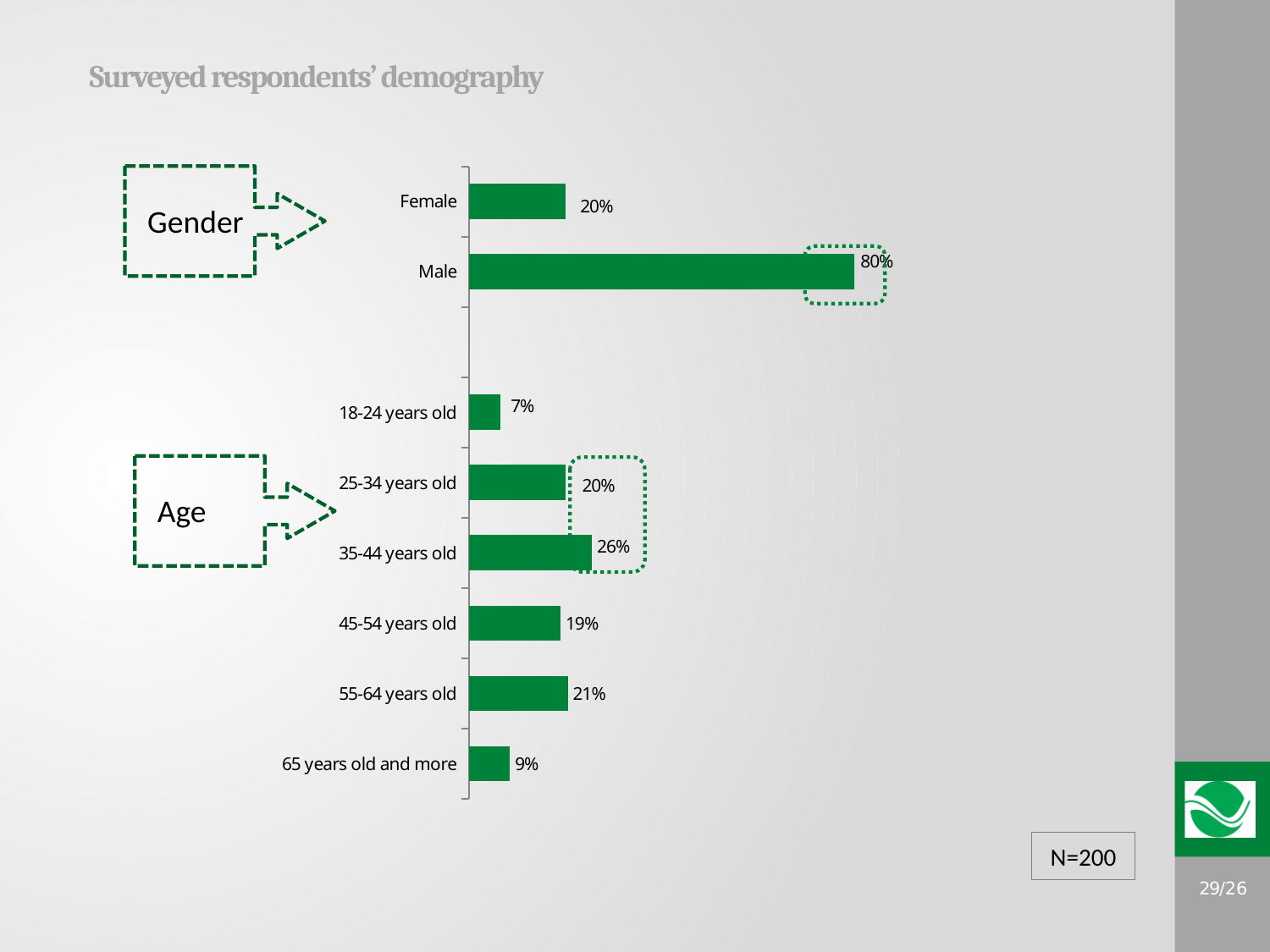
Which is larger, the share of respondents aged 55-64 years old or 45-54 years old? 55-64 years old What percentage of surveyed respondents are female? 20% What is the difference between the 35-44 years old and 45-54 years old shares? 7% Which age group has the highest share of respondents? 35-44 years old What type of chart is used on this slide? Bar chart What is the difference between the percentage of male and female respondents? 60% What percentage of surveyed respondents are male? 80% What is the value shown for respondents aged 65 years old and more? 9% What is the sample size (N) stated on the slide? N=200 Which age group has the lowest share of respondents? 18-24 years old How many age groups are shown in the chart? 6 What is the value shown for respondents aged 35-44 years old? 26%